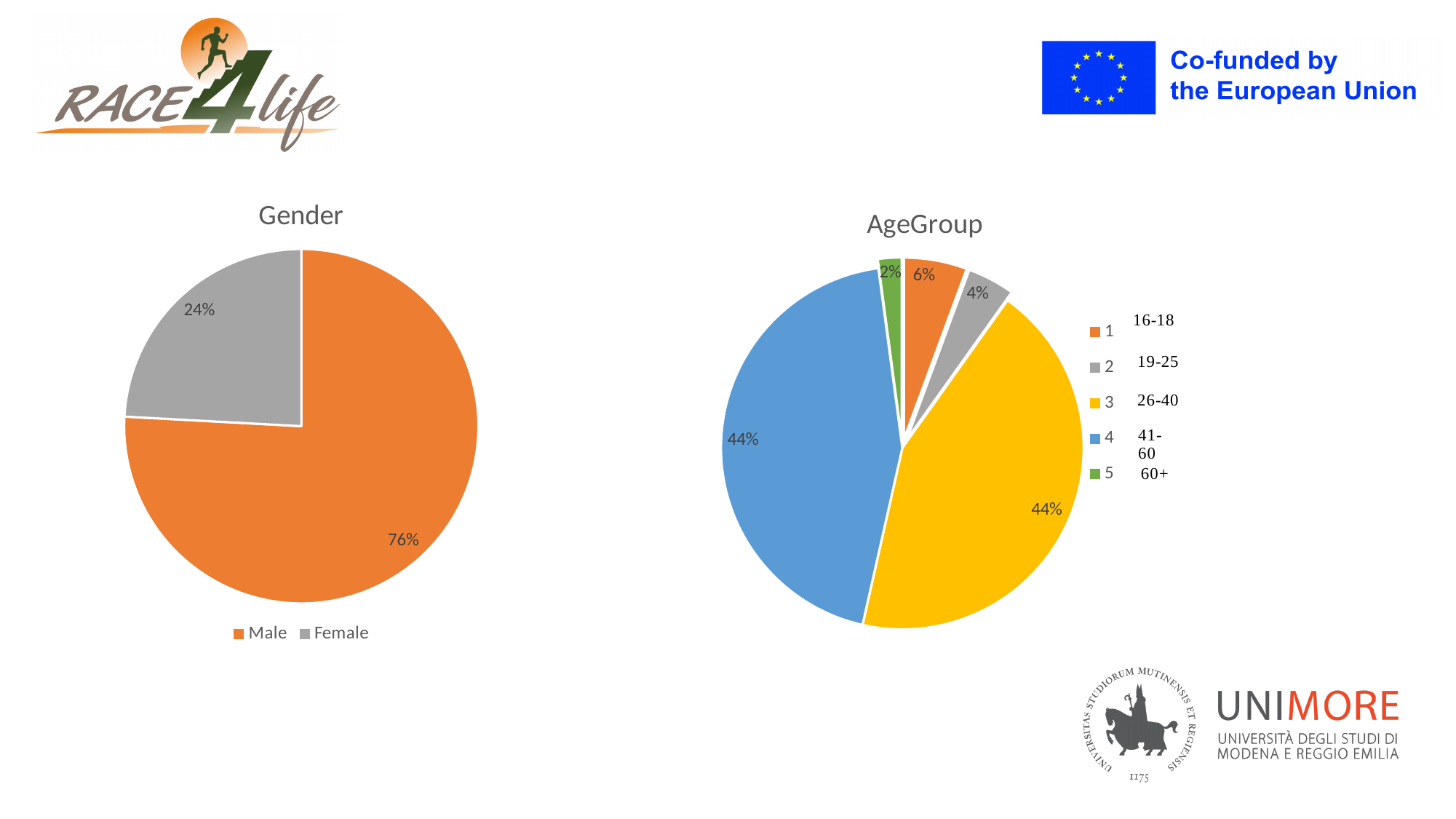
In the Gender chart, what is the difference in percentage points between Male and Female? 52 What kind of chart is the Gender chart? Pie chart In the Gender chart, which category has the larger share? Male In the AgeGroup chart, which group has the smallest share? 5 (60+) How many slices does the AgeGroup chart have? 5 In the AgeGroup chart, what percentage is group 1 (16-18)? 6% In the AgeGroup chart, what colour is the slice for group 4 (41-60)? Blue In the Gender chart, what percentage is Female? 24% In the AgeGroup chart, what percentage is group 3 (26-40)? 44% In the AgeGroup chart, which is larger, group 1 (16-18) or group 2 (19-25)? Group 1 (16-18) In the Gender chart, what percentage is Male? 76% In the AgeGroup chart, what percentage is group 2 (19-25)? 4%